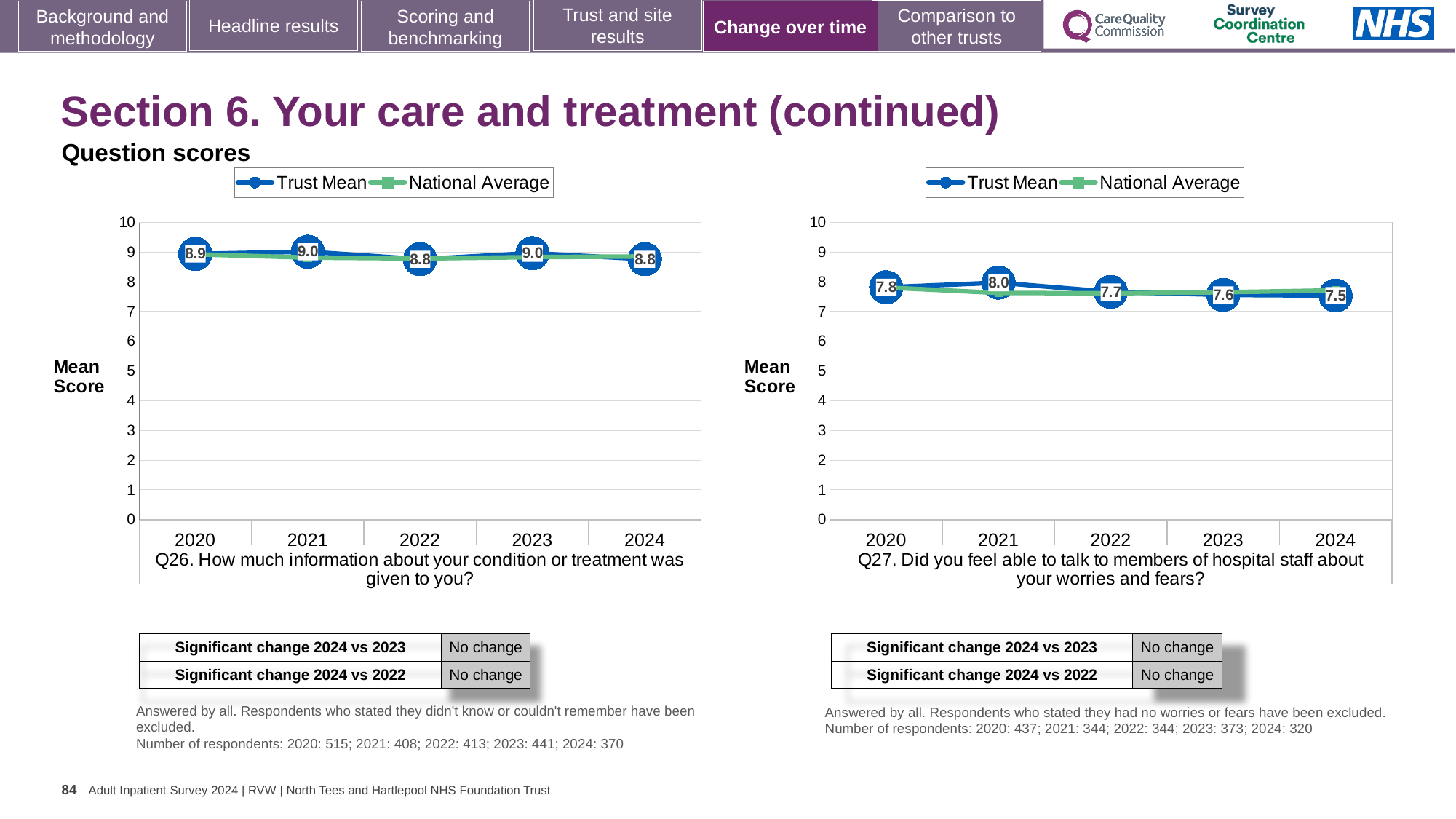
In the Q27 chart on the right, is the Trust Mean value for 2024 greater or less than 8? less In the Q27 chart on the right, what is the difference between the Trust Mean scores for 2021 and 2024? 0.5 In the Q27 chart on the right, what is the Trust Mean score for 2021? 8.0 In the Q27 chart on the right, which year has the highest Trust Mean score? 2021 In the Q26 chart on the left, what is the Trust Mean score for 2020? 8.9 In the Q27 chart on the right, which year has the lowest Trust Mean score? 2024 In the Q26 chart on the left, what is the Trust Mean score for 2024? 8.8 In the Q26 chart on the left, is the Trust Mean score for 2021 larger or smaller than the score for 2022? larger What kind of chart is the Q26 chart on the left? line chart How many years are shown on the x axis of the Q26 chart on the left? 5 In the Q27 chart on the right, does the Trust Mean score rise or fall from 2021 to 2024? fall How many series does the legend of the Q27 chart on the right list? 2